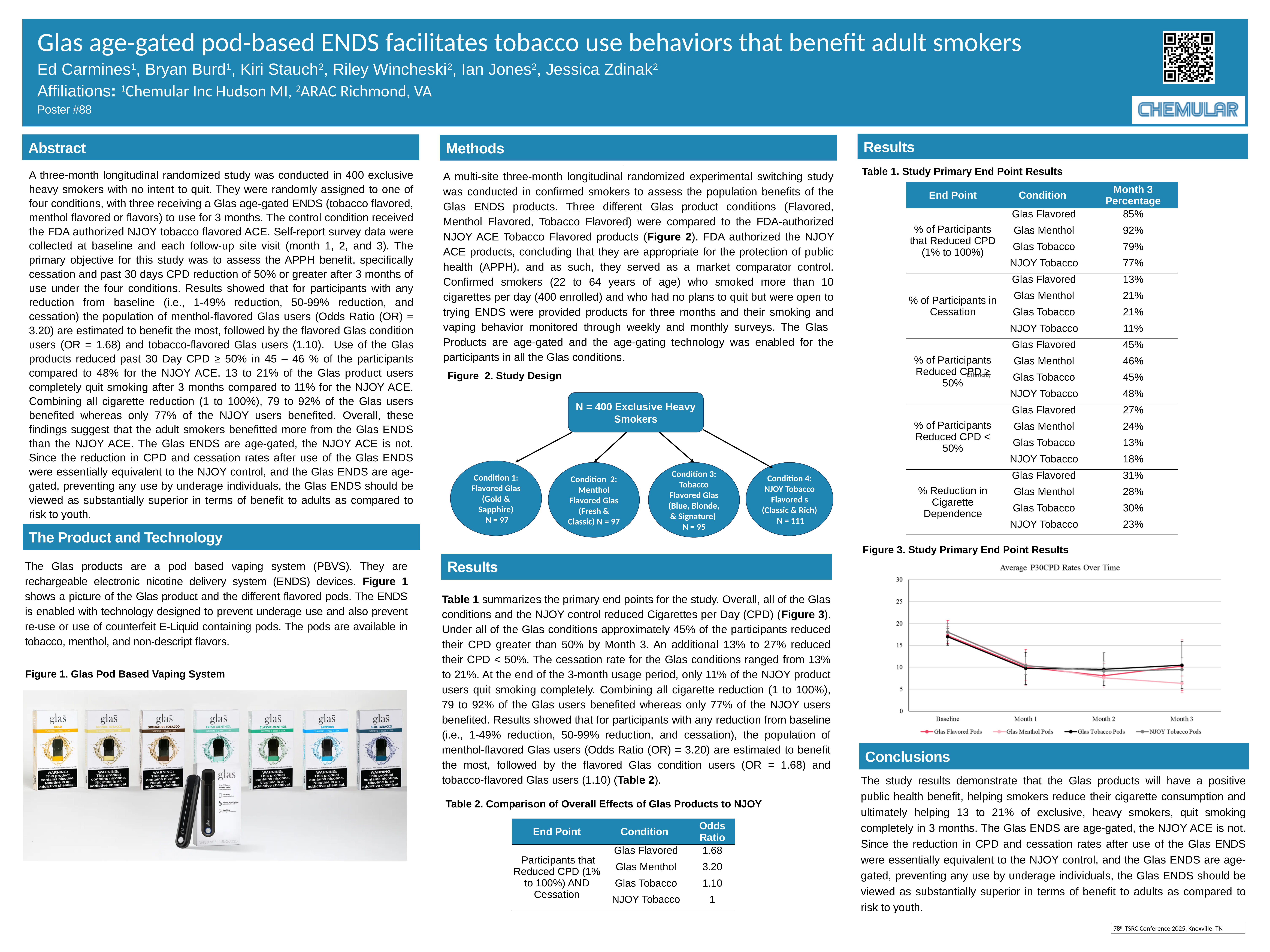
Which series are listed in the legend of the 'Average P30CPD Rates Over Time' chart? Glas Flavored Pods, Glas Menthol Pods, Glas Tobacco Pods, NJOY Tobacco Pods In the 'Average P30CPD Rates Over Time' chart, is the Baseline value for Glas Tobacco Pods greater or less than 15? greater What is the title of the chart in Figure 3? Average P30CPD Rates Over Time How many time points are shown on the x axis of the 'Average P30CPD Rates Over Time' chart? 4 How many series does the legend of the 'Average P30CPD Rates Over Time' chart list? 4 In the 'Average P30CPD Rates Over Time' chart, what is the highest value shown on the y axis? 30 In the 'Average P30CPD Rates Over Time' chart, is the Month 3 value for Glas Menthol Pods greater or less than 15? less In the 'Average P30CPD Rates Over Time' chart, is the Month 1 value for NJOY Tobacco Pods greater or less than 15? less In the 'Average P30CPD Rates Over Time' chart, at which time point are the values for all series highest? Baseline In the 'Average P30CPD Rates Over Time' chart, do the values rise or fall from Baseline to Month 1? fall What kind of chart is Figure 3, 'Average P30CPD Rates Over Time'? line chart In the 'Average P30CPD Rates Over Time' chart, which is larger for Glas Flavored Pods: the Baseline value or the Month 3 value? Baseline